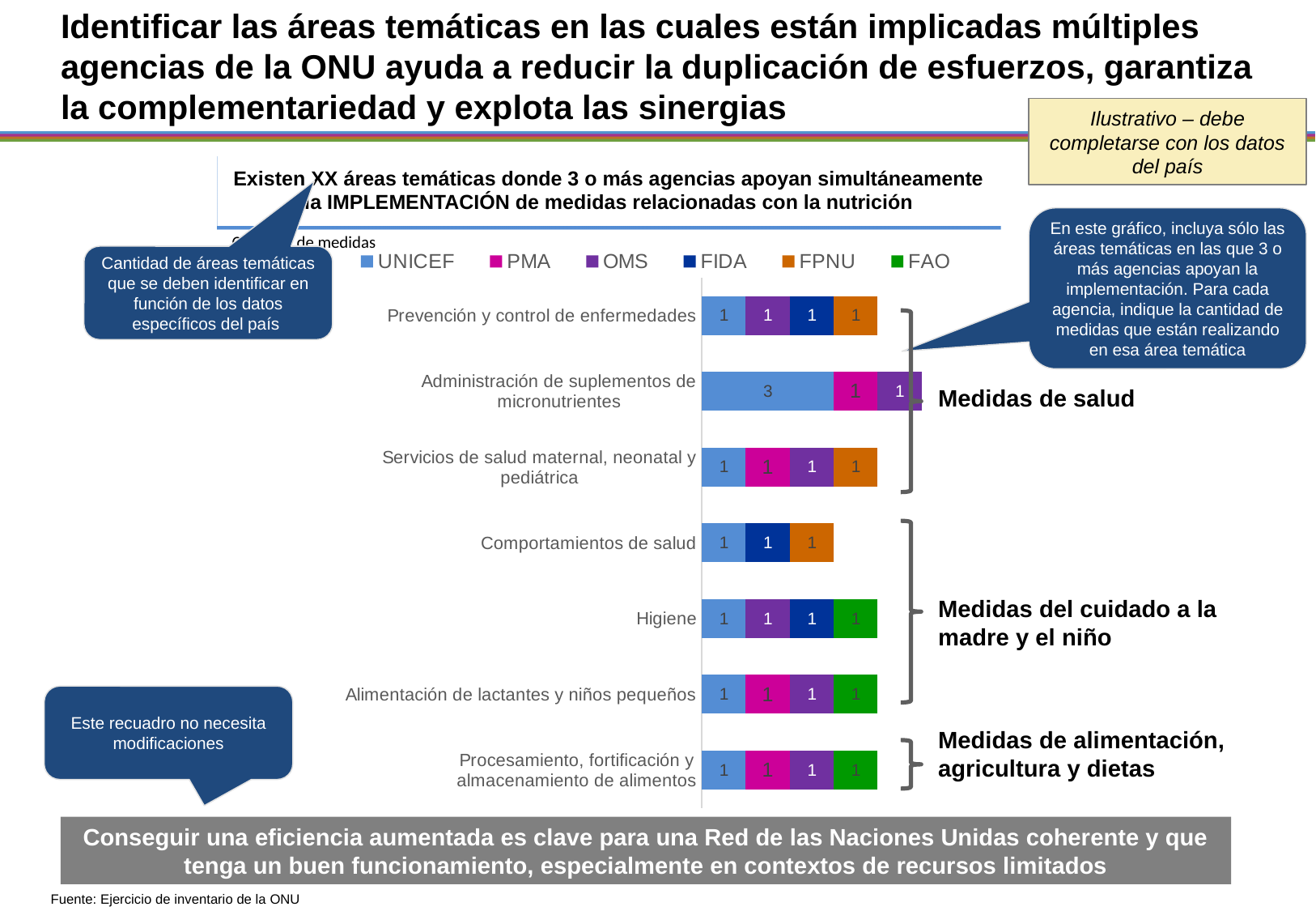
What is the FPNU value for 'Comportamientos de salud'? 1 Which thematic area has the lowest total number of measures? Comportamientos de salud What is the total of the stacked bar for 'Administración de suplementos de micronutrientes'? 5 How many thematic areas (categories) are plotted in the chart? 7 What kind of chart is shown on the slide? Stacked bar chart How many series does the chart legend list? 6 What is the UNICEF value for 'Administración de suplementos de micronutrientes'? 3 What is the difference between the UNICEF value for 'Administración de suplementos de micronutrientes' and the UNICEF value for 'Higiene'? 2 Which thematic area has the highest total number of measures? Administración de suplementos de micronutrientes Which agency is listed first in the chart legend? UNICEF What is the total of the stacked bar for 'Higiene'? 4 What is the total of the stacked bar for 'Comportamientos de salud'? 3